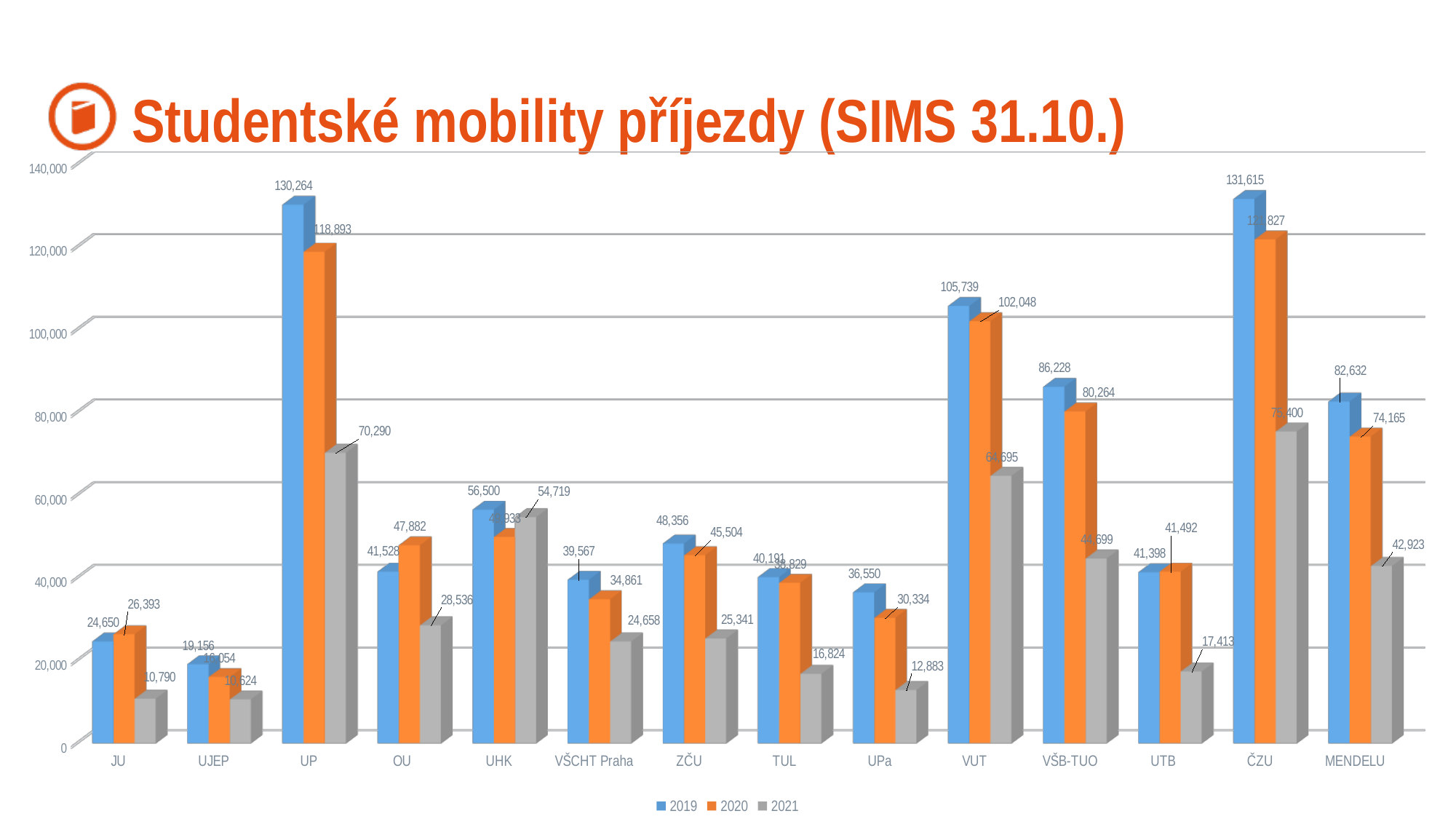
What is the difference between the 2019 and 2020 values for UP? 11,371 For OU, which is larger: the 2019 value or the 2020 value? 2020 What is the 2020 value for UPa? 30,334 What is the 2021 value for MENDELU? 42,923 How many series does the legend list? 3 How many universities (categories) are shown on the x axis? 14 Which university has the highest 2019 value? ČZU What kind of chart is shown on the slide? bar chart What are the entries in the chart legend? 2019, 2020, 2021 Is the 2021 value for VUT greater or less than 60,000? greater Which university has the lowest 2019 value? UJEP What is the 2019 value for UP? 130,264